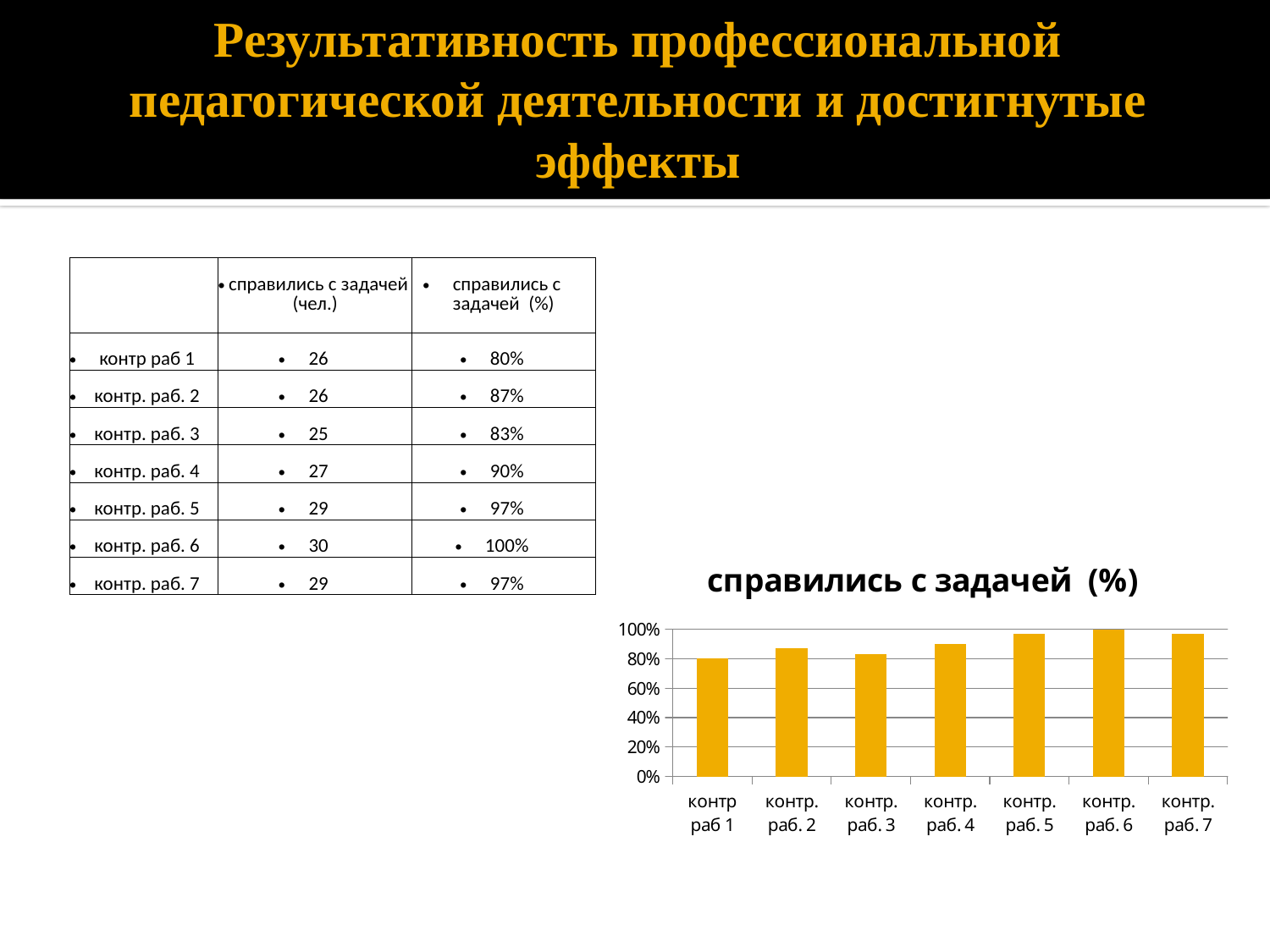
What kind of chart is shown on the slide? bar chart What is the value for контр. раб. 4 according to the slide? 90% What is the title of the chart? справились с задачей (%) What is the difference between the values for контр. раб. 6 and контр раб 1? 20% Which category has the highest value in the chart? контр. раб. 6 What is the value for контр раб 1 in the chart? 80% Which is larger, the value for контр. раб. 4 or the value for контр раб 1? контр. раб. 4 Which category has the lowest value in the chart? контр раб 1 Is the value for контр. раб. 3 greater or less than 60%? greater How many categories (контрольные работы) are plotted in the chart? 7 What colour are the bars in the chart? yellow/orange What is the value for контр. раб. 6 in the chart? 100%